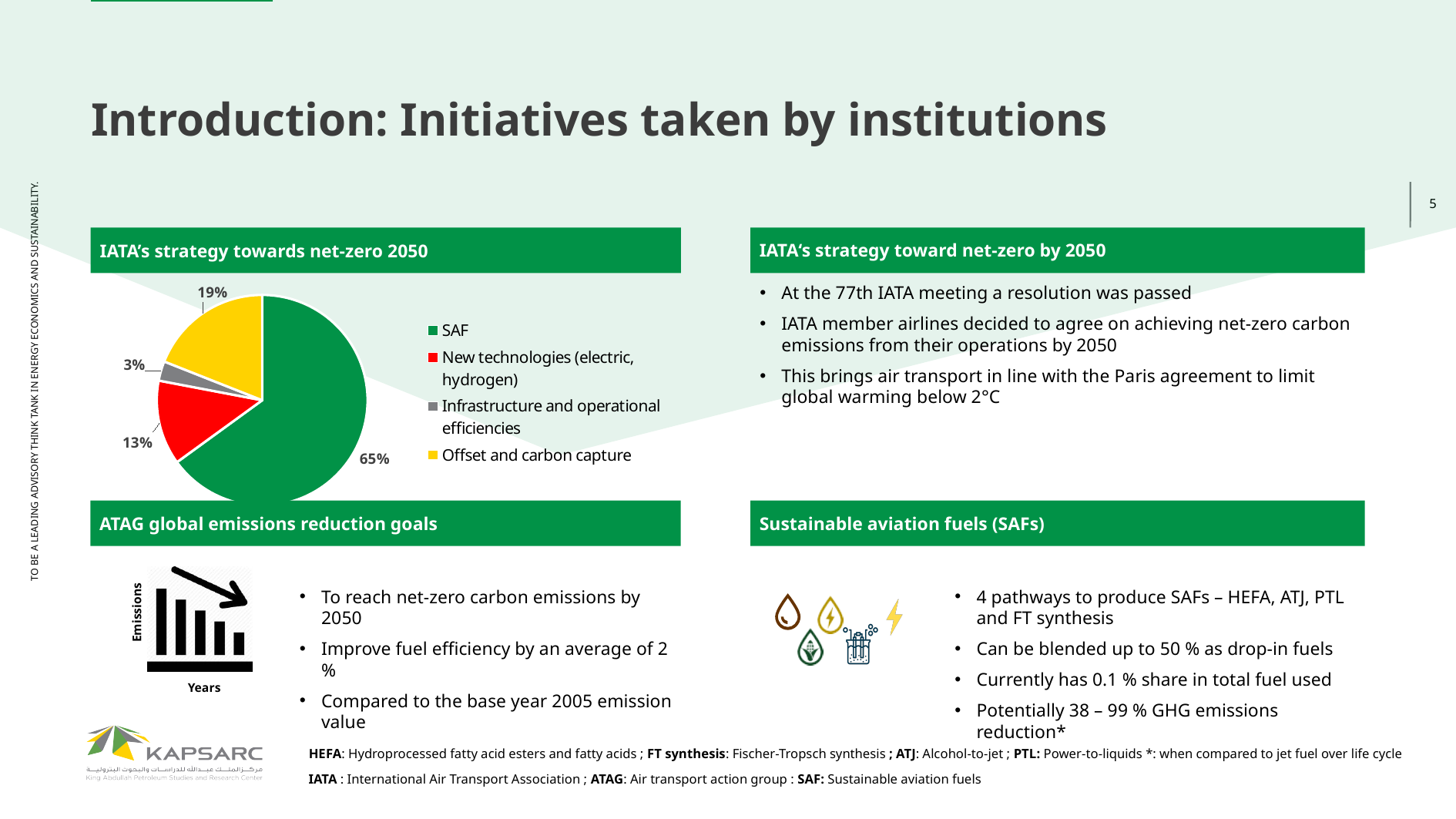
What share of the pie chart does Offset and carbon capture account for? 19% Which category has the largest slice in the pie chart? SAF What is the difference in percentage points between the SAF slice and the Offset and carbon capture slice? 46 Which slice is larger: New technologies (electric, hydrogen) or Offset and carbon capture? Offset and carbon capture What is the title of the section containing the pie chart? IATA's strategy towards net-zero 2050 What share of the pie chart does SAF account for? 65% What colour is the SAF slice in the pie chart? Green Which category has the smallest slice in the pie chart? Infrastructure and operational efficiencies How many categories are shown in the pie chart? 4 What type of chart is used to show IATA's strategy towards net-zero 2050? Pie chart What share of the pie chart does New technologies (electric, hydrogen) account for? 13% What share of the pie chart does Infrastructure and operational efficiencies account for? 3%